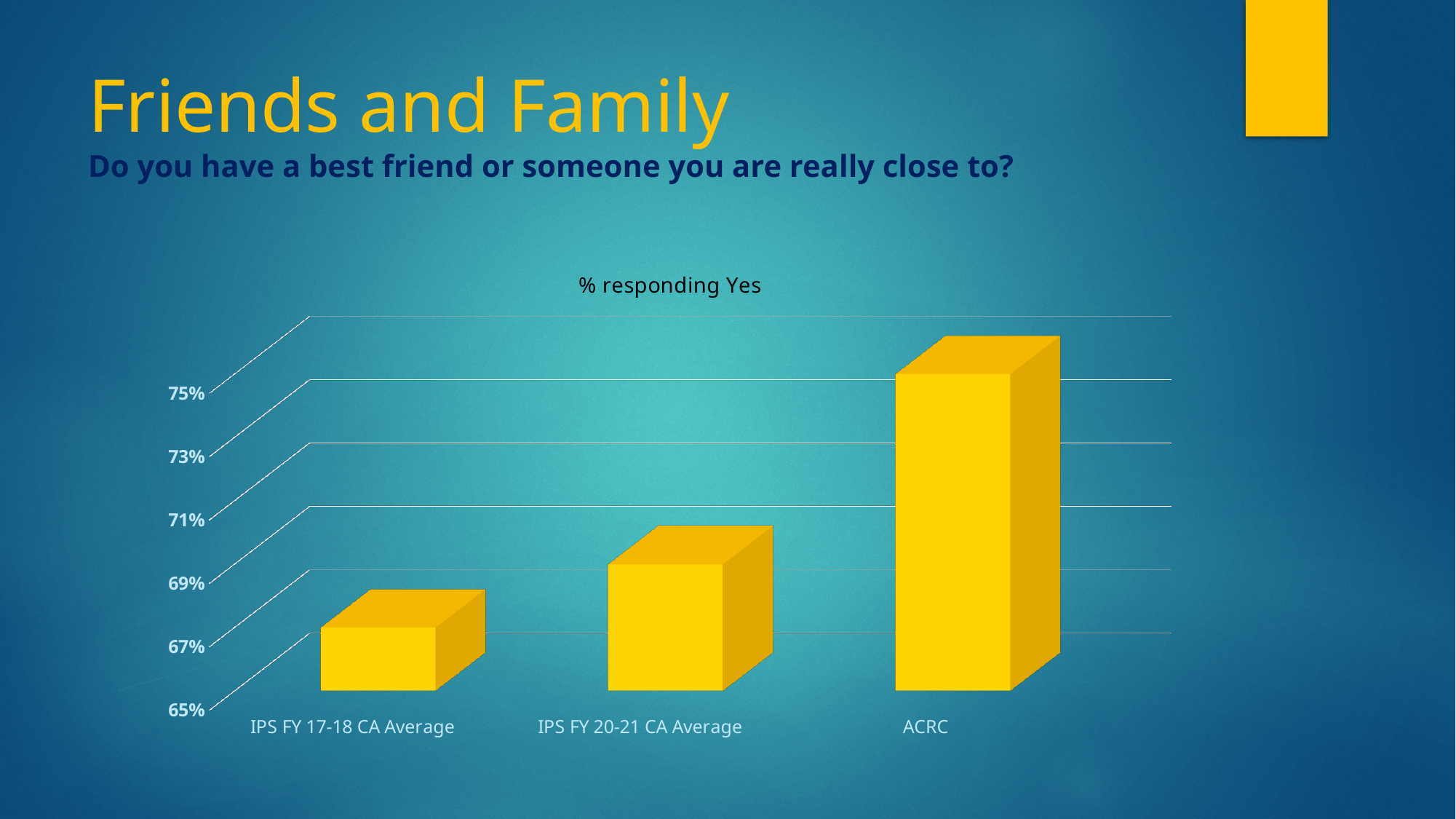
Which is larger, the value for ACRC or the value for IPS FY 20-21 CA Average? ACRC Do the values rise or fall moving left to right across the categories? rise Which category has the lowest percentage responding Yes? IPS FY 17-18 CA Average Which category has the highest percentage responding Yes? ACRC What colour are the bars in the chart? yellow Is the value for IPS FY 17-18 CA Average greater or less than 69%? less How many categories are plotted in the chart? 3 What is the title of the chart? % responding Yes Is the value for IPS FY 20-21 CA Average greater or less than 71%? less Which is larger, the value for IPS FY 20-21 CA Average or the value for IPS FY 17-18 CA Average? IPS FY 20-21 CA Average Is the value for ACRC greater or less than 73%? greater What type of chart is shown on the slide? bar chart